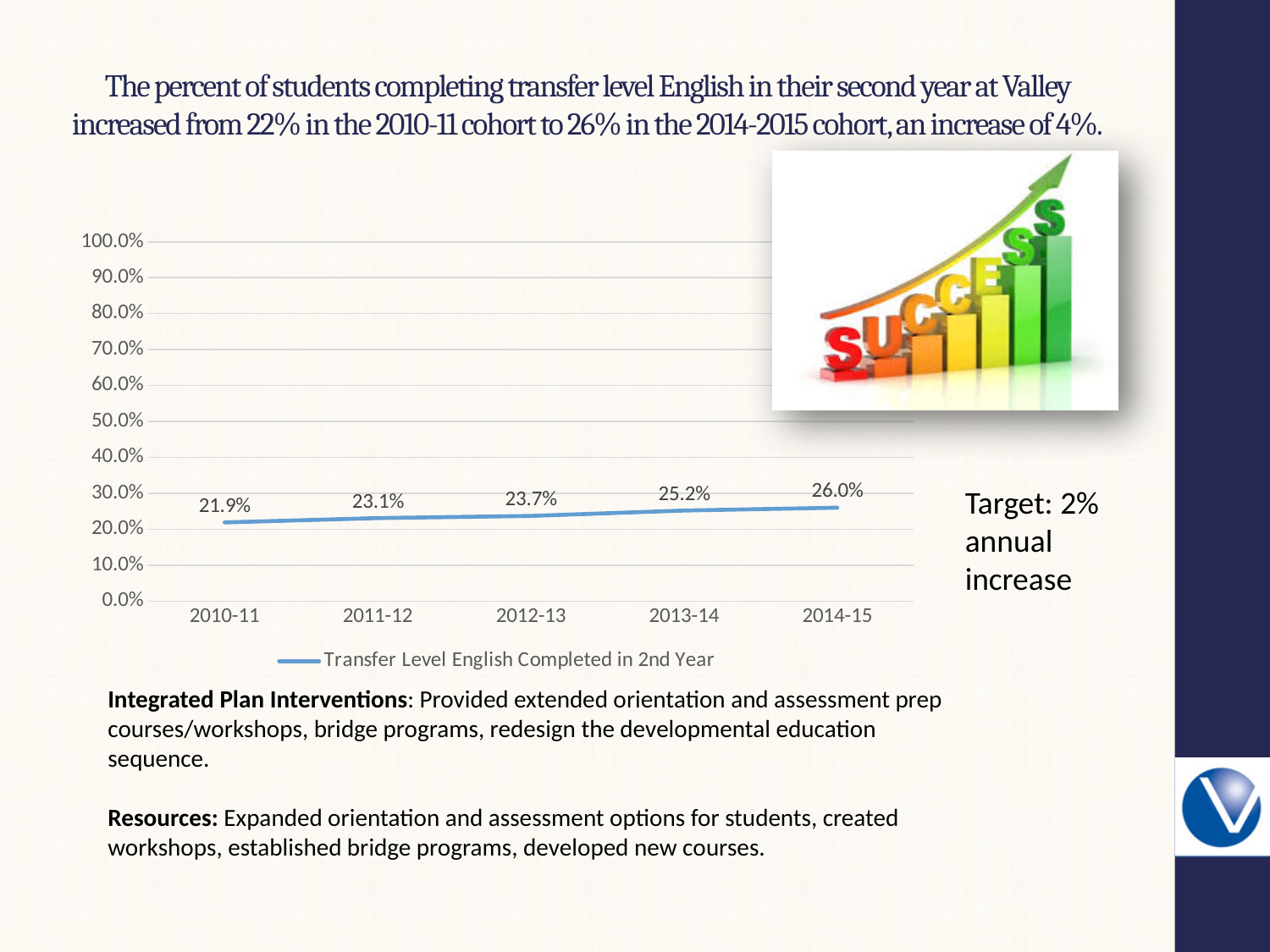
How many years are plotted on the x axis of the chart? 5 What kind of chart is shown on the slide? line chart Do the values rise or fall from 2010-11 to 2014-15? rise What is the difference between the values for 2013-14 and 2012-13? 1.5% What is the difference between the values for 2014-15 and 2010-11? 4.1% What is the value for 2010-11 in the Transfer Level English Completed in 2nd Year chart? 21.9% Which year has the lowest value in the chart? 2010-11 Which year has the highest value in the chart? 2014-15 Which is larger, the value for 2011-12 or the value for 2013-14? 2013-14 What is the value for 2014-15 in the chart? 26.0% What is the value for 2012-13 in the chart? 23.7% Is the value for 2014-15 greater or less than 30.0%? less